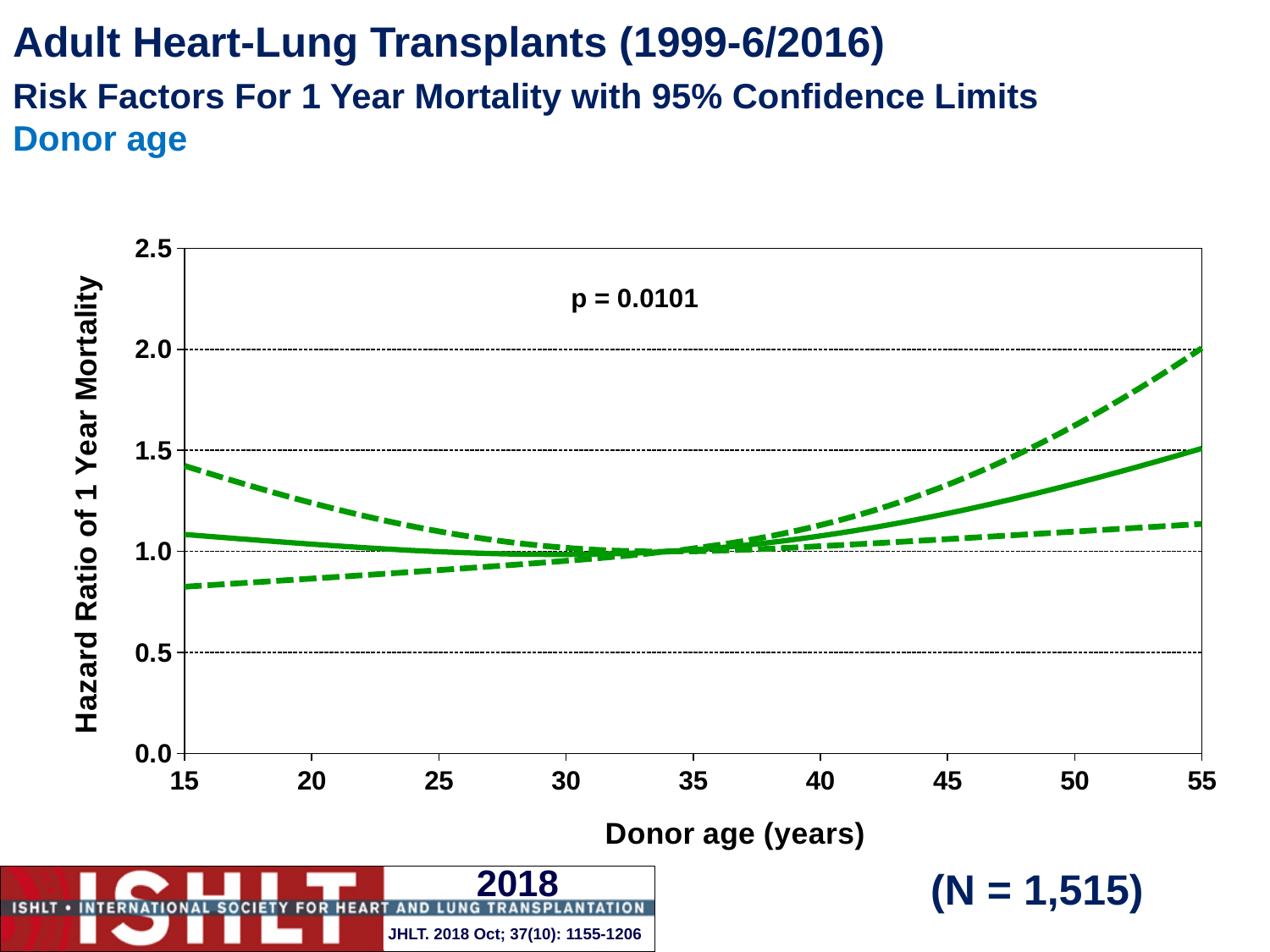
Does the hazard ratio (solid line) rise or fall as donor age increases from 35 to 55 years? rise What is the p-value printed on the chart? p = 0.0101 Is the hazard ratio (solid line) at donor age 50 greater or less than 1.5? less Is the upper 95% confidence limit at donor age 15 greater or less than 1.5? less Is the lower 95% confidence limit at donor age 15 greater or less than 1.0? less How many lines (curves) are plotted on the chart? 3 What is the sample size (N) shown on the slide? N = 1,515 What kind of chart is shown on the slide? line chart